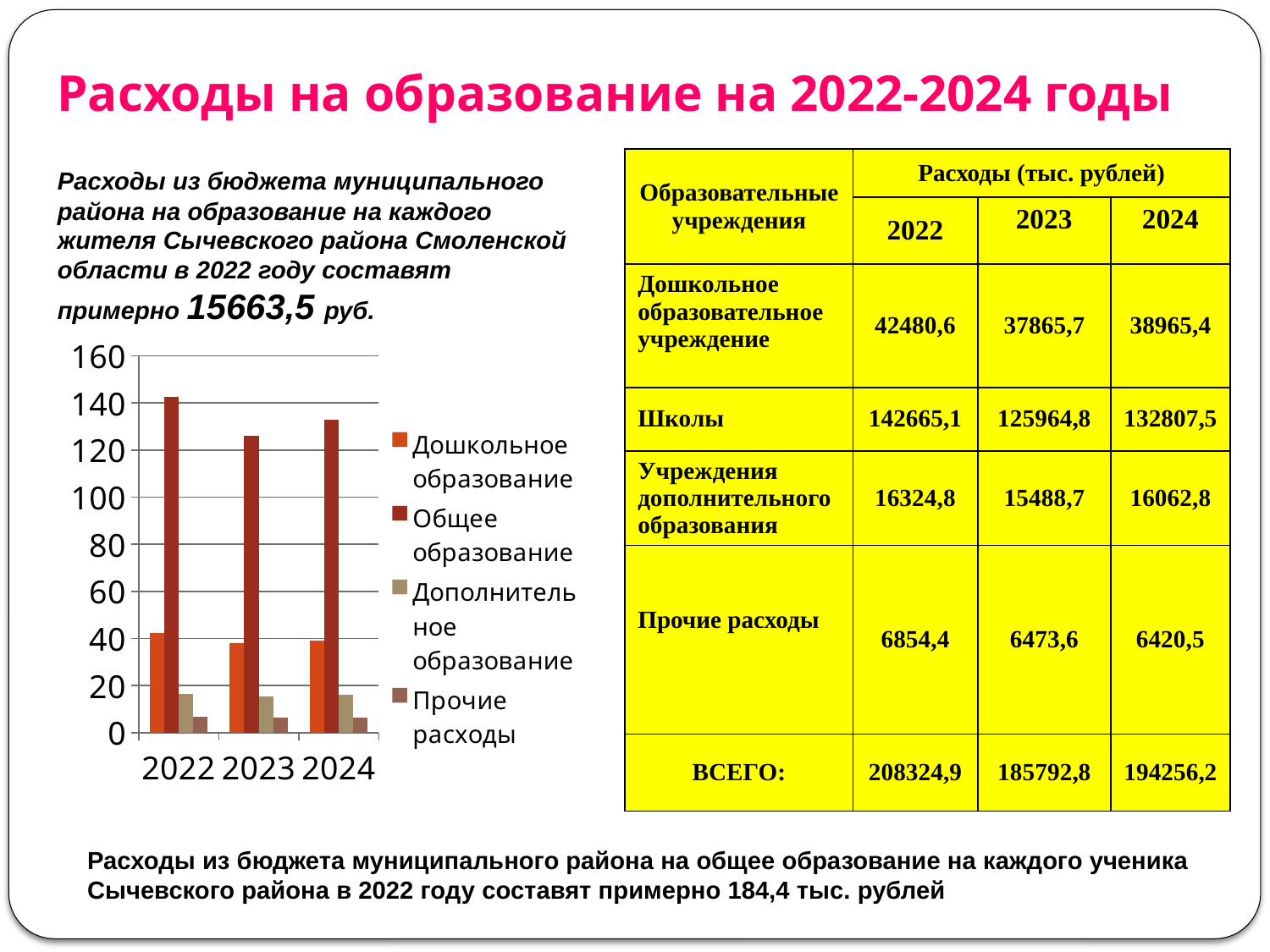
What kind of chart is shown on the slide? bar chart Which is larger in the chart: Дошкольное образование in 2022 or Дополнительное образование in 2022? Дошкольное образование Is the value for Дошкольное образование in 2023 greater or less than 40? less Which series has the shortest bars in the chart? Прочие расходы How many series does the chart legend list? 4 How many years are shown on the x axis of the chart? 3 In which year is the bar for Общее образование the highest? 2022 In which year is the bar for Общее образование the lowest? 2023 Is the value for Общее образование in 2022 greater or less than 140? greater Which series has the tallest bars in the chart? Общее образование Does the bar for Общее образование rise or fall from 2022 to 2023? fall Is the value for Общее образование in 2024 greater or less than 120? greater